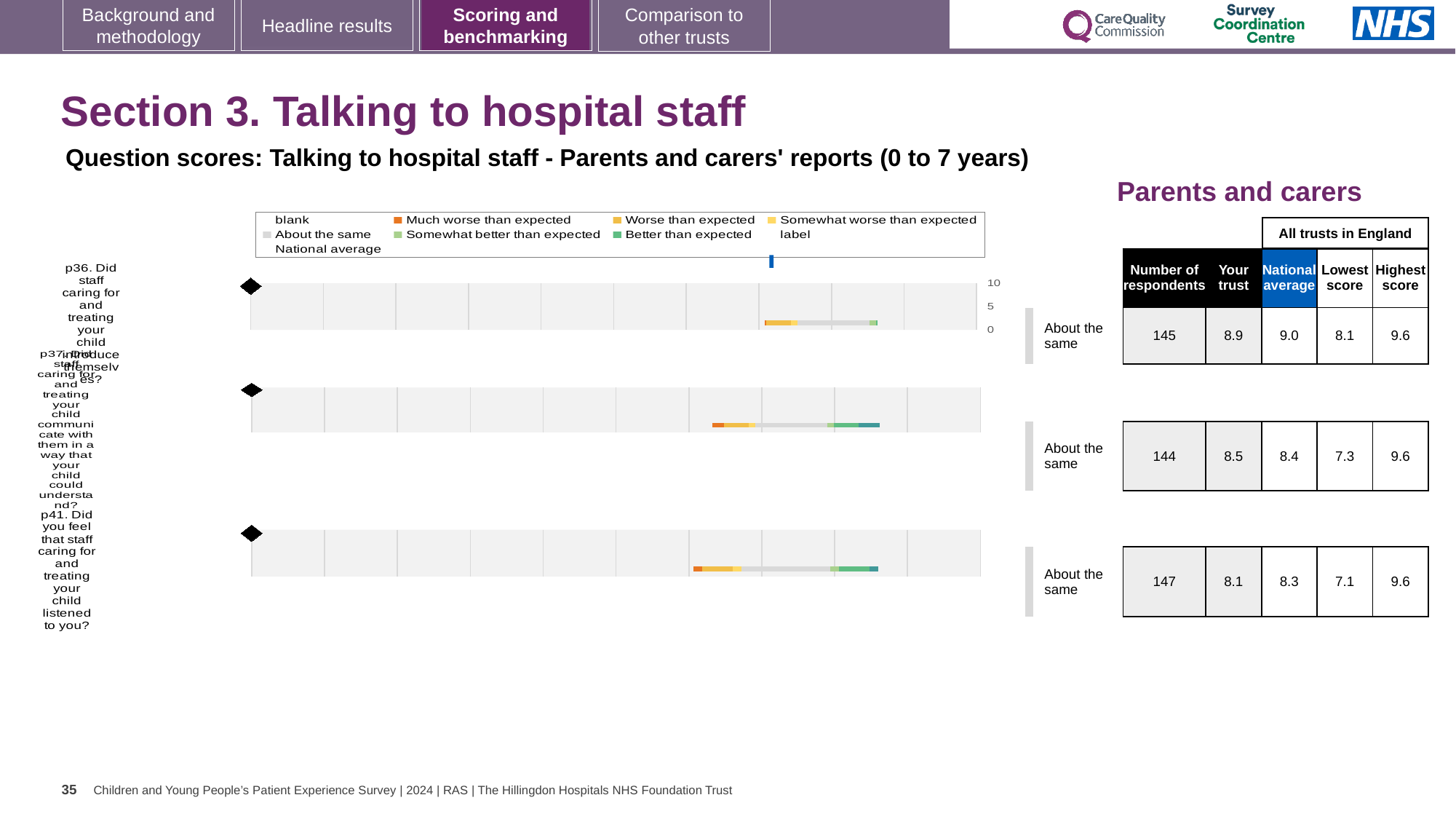
How many respondents answered p41 (Did you feel that staff listened to you)? 147 What benchmark label is shown next to the p36 chart? About the same What is the lowest score among all trusts in England for p41? 7.1 What is the national average score for p37 (Did staff communicate with your child in a way they could understand)? 8.4 For p37, which is larger: the 'Your trust' score or the national average? Your trust Which question has the highest 'Your trust' score? p36 For p36, what is the difference between the national average and the 'Your trust' score? 0.1 What kind of chart is used to show the question scores on this slide? bar chart According to the legend, what does the blue marker represent? National average How many questions (p36, p37, p41) are plotted on the slide? 3 What is the 'Your trust' score for p36 (Did staff caring for and treating your child introduce themselves)? 8.9 Which question has the lowest 'Your trust' score? p41